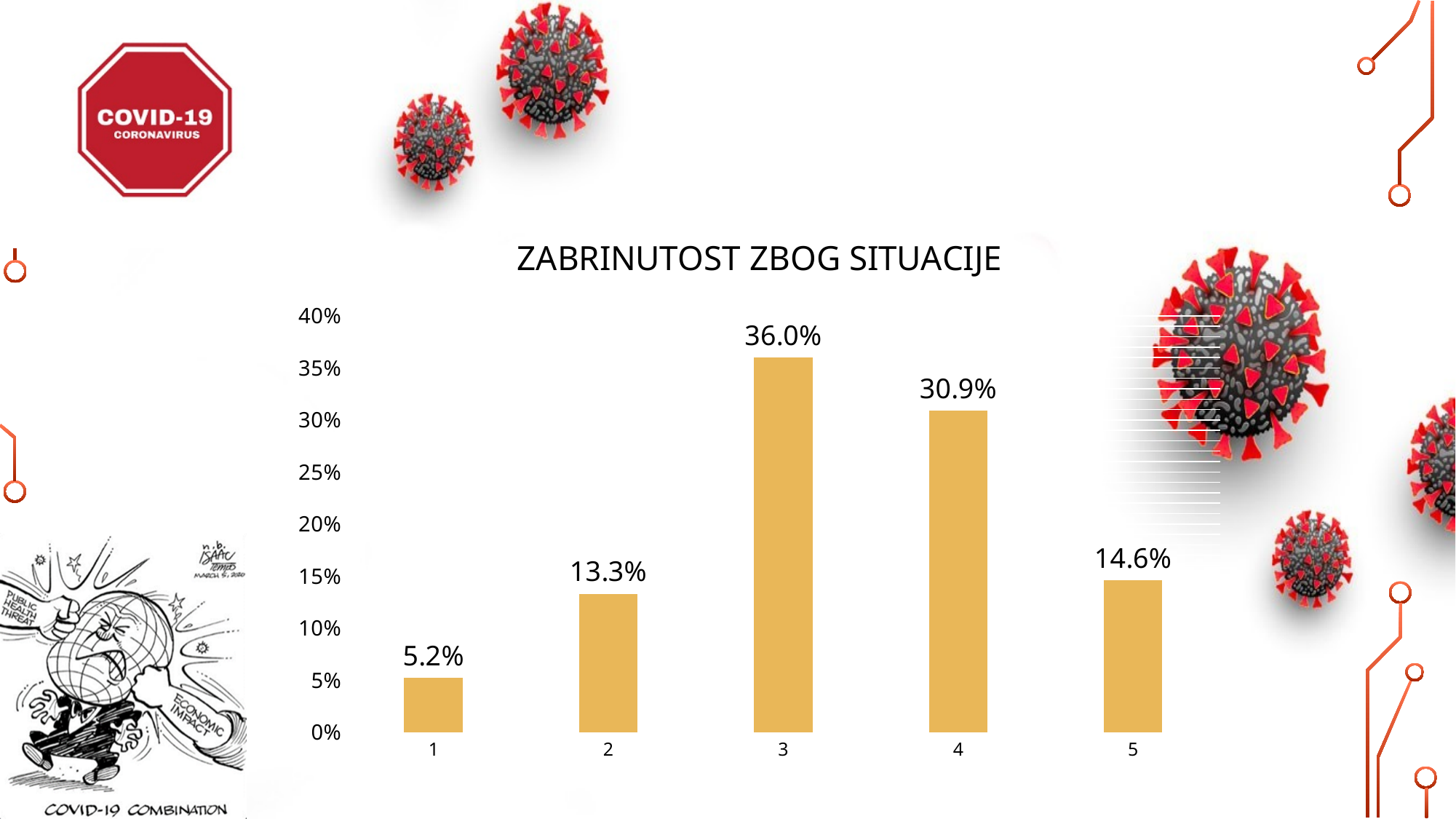
What is the difference between the values for category 5 and category 2? 1.3% What kind of chart is shown on the slide? bar chart Which category has the highest value? 3 What is the value for category 5? 14.6% What is the value for category 3? 36.0% Which is larger, the value for category 2 or the value for category 5? 5 How many categories are shown on the x axis? 5 Which category has the lowest value? 1 What is the value for category 1? 5.2% What is the title of the chart? ZABRINUTOST ZBOG SITUACIJE Is the value for category 4 greater or less than 30%? greater What is the difference between the values for category 3 and category 4? 5.1%